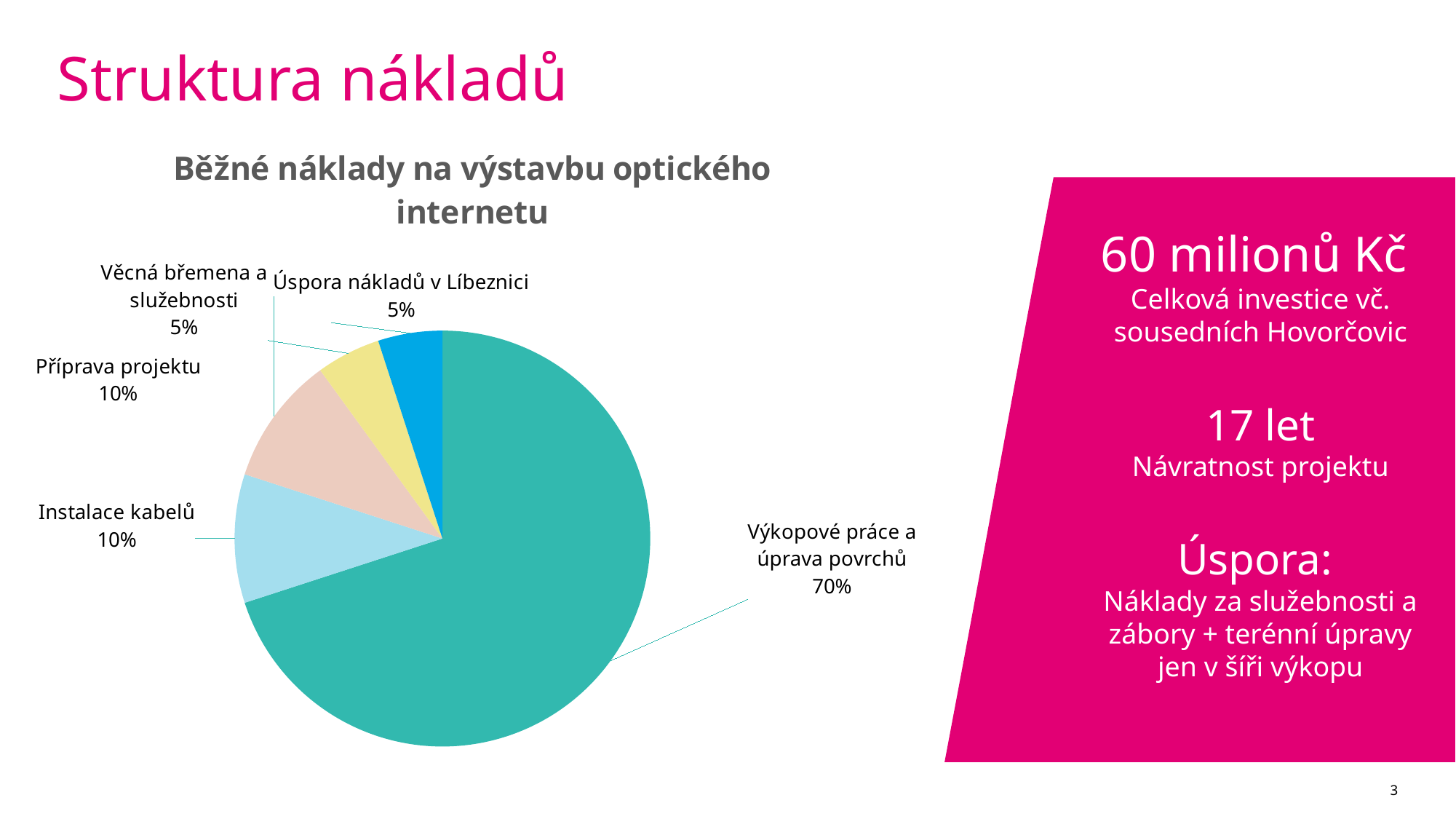
What is the difference between the share for Výkopové práce a úprava povrchů and the share for Instalace kabelů? 60% How many slices does the pie chart have? 5 What is the value shown for Úspora nákladů v Líbeznici? 5% What is the value shown for Instalace kabelů? 10% What is the value shown for Věcná břemena a služebnosti? 5% What kind of chart is shown on the slide? Pie chart What is the value shown for Příprava projektu? 10% What share of the pie does Výkopové práce a úprava povrchů have? 70% What colour is the slice for Výkopové práce a úprava povrchů? Teal Which is larger, the share for Příprava projektu or the share for Úspora nákladů v Líbeznici? Příprava projektu What is the title of the pie chart? Běžné náklady na výstavbu optického internetu Which category has the largest slice of the pie? Výkopové práce a úprava povrchů